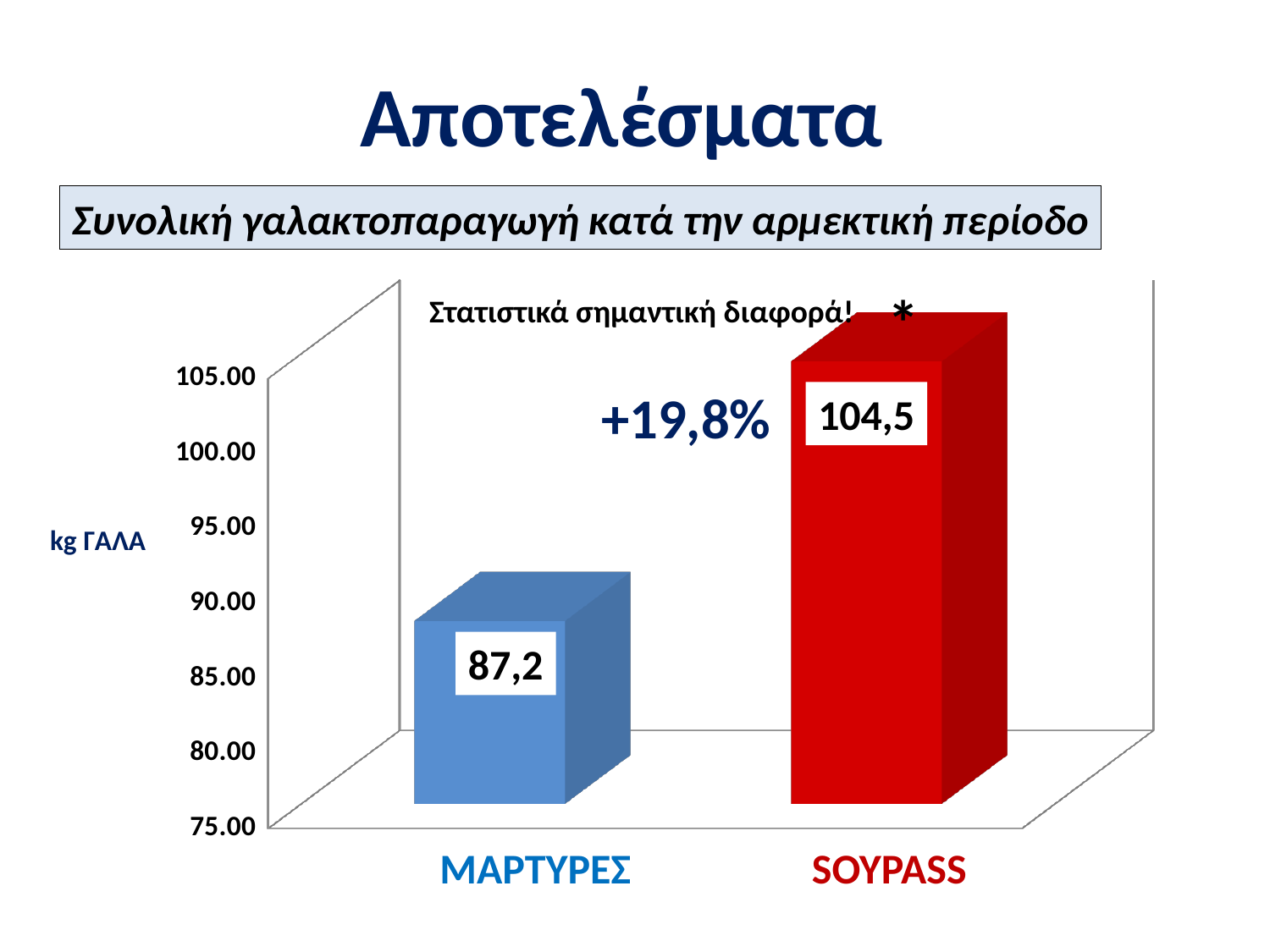
What percentage increase is annotated on the chart? +19,8% What is the label of the y axis? kg ΓΑΛΑ Is the value for SOYPASS greater or less than 100.00? greater Which is larger, the value for ΜΑΡΤΥΡΕΣ or the value for SOYPASS? SOYPASS What is the value for ΜΑΡΤΥΡΕΣ? 87,2 What kind of chart is shown on the slide? bar chart Is the value for ΜΑΡΤΥΡΕΣ greater or less than 90.00? less What is the value for SOYPASS? 104,5 What is the difference between the SOYPASS value and the ΜΑΡΤΥΡΕΣ value? 17,3 Which category has the highest value? SOYPASS How many categories are shown on the x axis? 2 Which category has the lowest value? ΜΑΡΤΥΡΕΣ